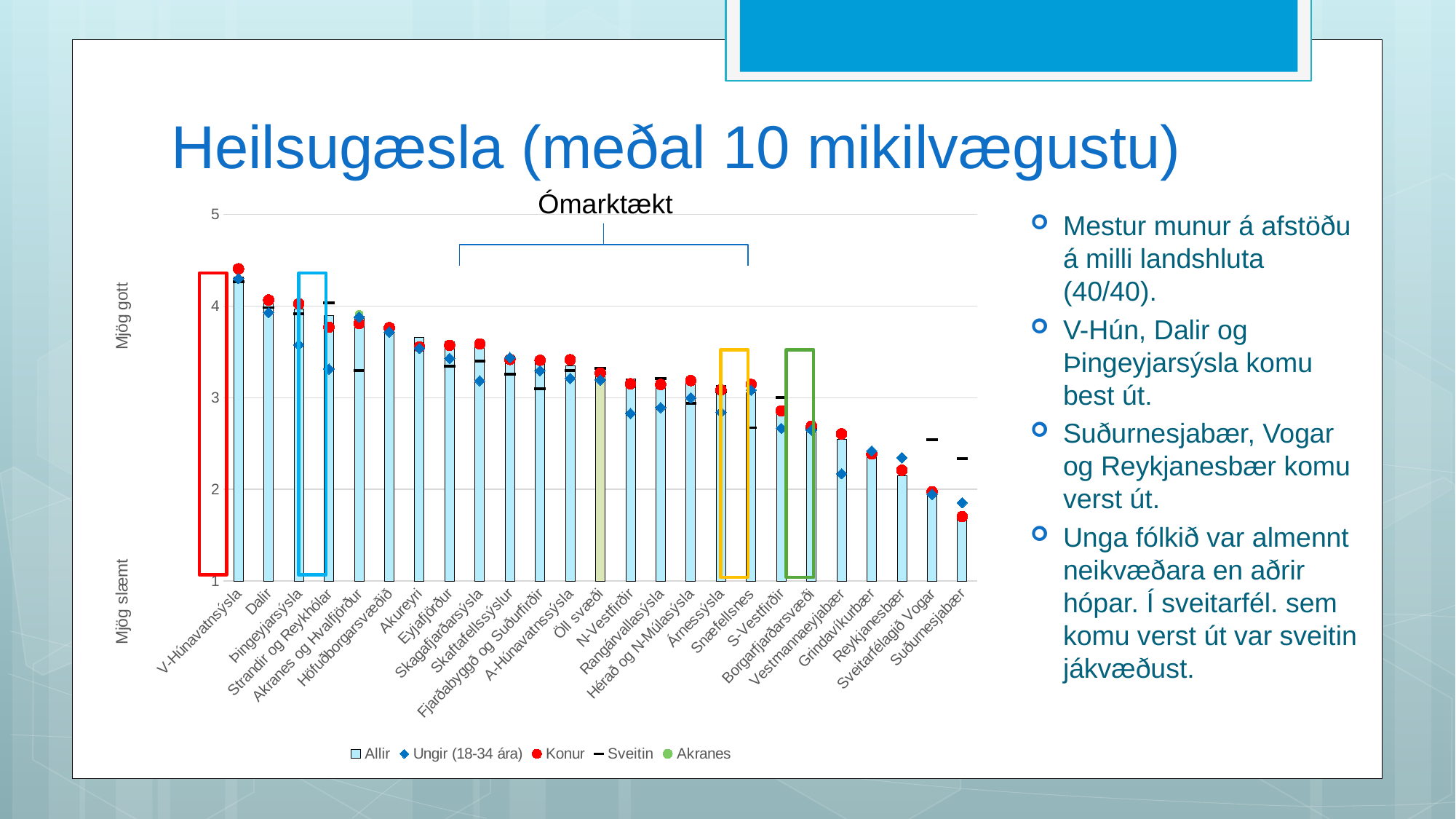
Do the Allir bar values rise or fall moving from left to right along the x axis? fall What kind of chart is shown on the slide? bar chart Which region has the highest Allir bar in the chart? V-Húnavatnsýsla Is the Allir value for Suðurnesjabær greater or less than 2? less Which region has the lowest Allir bar in the chart? Suðurnesjabær Is the Allir value for V-Húnavatnsýsla greater or less than 4? greater Which has the larger Allir value, Akureyri or Reykjanesbær? Akureyri What label appears at the top of the y axis of the chart? Mjög gott Is the Allir value for Vestmannaeyjabær greater or less than 3? less How many series does the chart legend list? 5 How many regions (categories) are shown along the x axis of the chart? 25 Which series is represented by the red dots in the chart? Konur